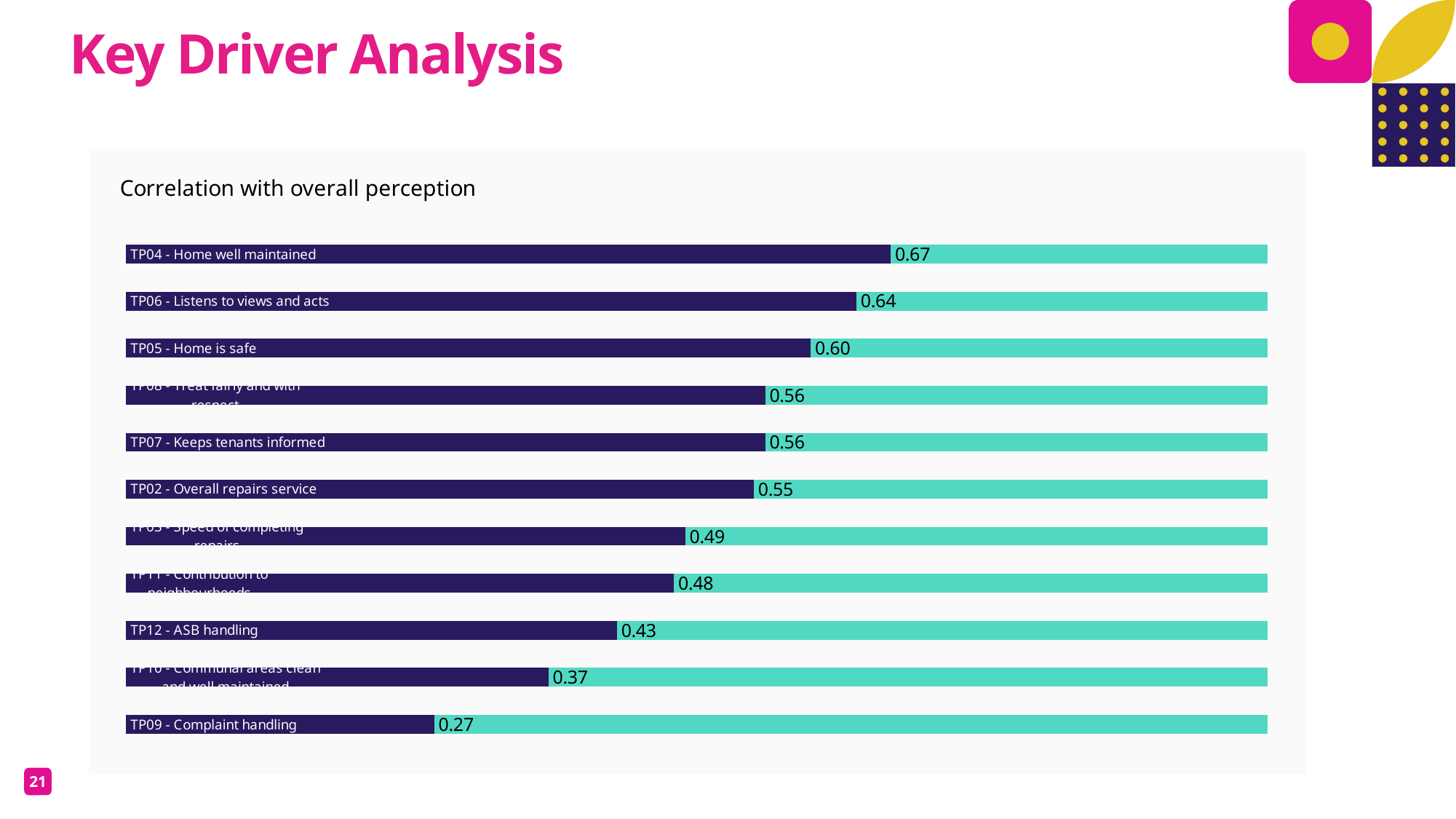
What is the difference between the correlation values for TP04 - Home well maintained and TP09 - Complaint handling? 0.40 What is the correlation value for TP04 - Home well maintained? 0.67 How many categories are shown in the chart? 11 What is the correlation value for TP05 - Home is safe? 0.60 Which has a higher correlation value: TP07 - Keeps tenants informed or TP12 - ASB handling? TP07 - Keeps tenants informed What is the difference between the correlation values for TP06 - Listens to views and acts and TP05 - Home is safe? 0.04 What is the correlation value for TP12 - ASB handling? 0.43 Which category has the lowest correlation with overall perception? TP09 - Complaint handling What type of chart is shown on the slide? Bar chart Which category has the highest correlation with overall perception? TP04 - Home well maintained What is the correlation value for TP09 - Complaint handling? 0.27 What is the correlation value for TP06 - Listens to views and acts? 0.64